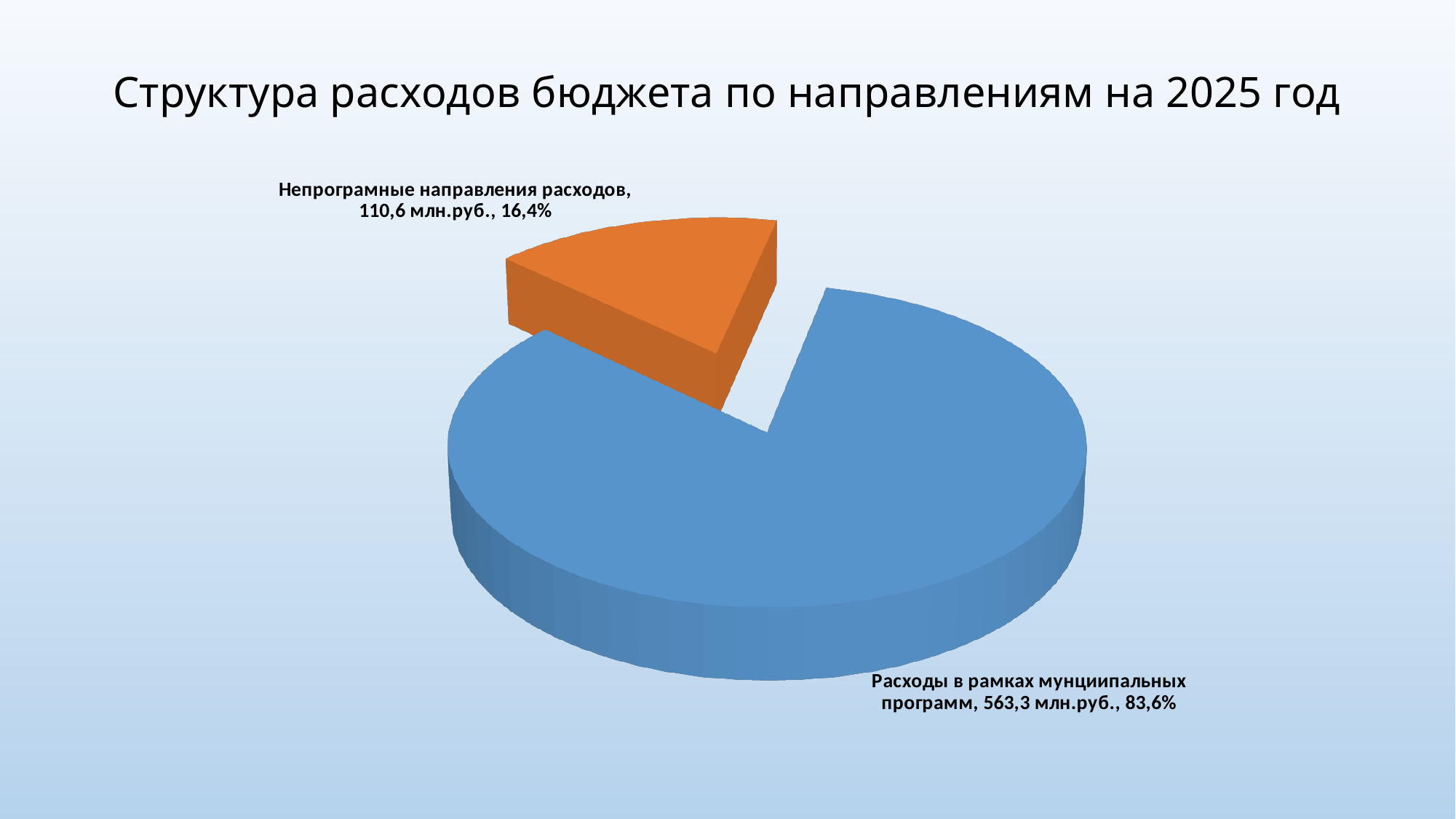
What is the difference in млн.руб. between Расходы в рамках мунциипальных программ and Непрограмные направления расходов? 452,7 млн.руб. What is the title of the chart? Структура расходов бюджета по направлениям на 2025 год Which is larger: Непрограмные направления расходов or Расходы в рамках мунциипальных программ? Расходы в рамках мунциипальных программ What is the value for Расходы в рамках мунциипальных программ? 563,3 млн.руб. What share of the pie does Расходы в рамках мунциипальных программ represent? 83,6% What is the value for Непрограмные направления расходов? 110,6 млн.руб. What share of the pie does Непрограмные направления расходов represent? 16,4% How many slices does the pie chart have? 2 Which category has the smallest share of the pie? Непрограмные направления расходов Which category has the largest share of the pie? Расходы в рамках мунциипальных программ What kind of chart is shown on the slide? Pie chart What colour is the slice for Непрограмные направления расходов? Orange